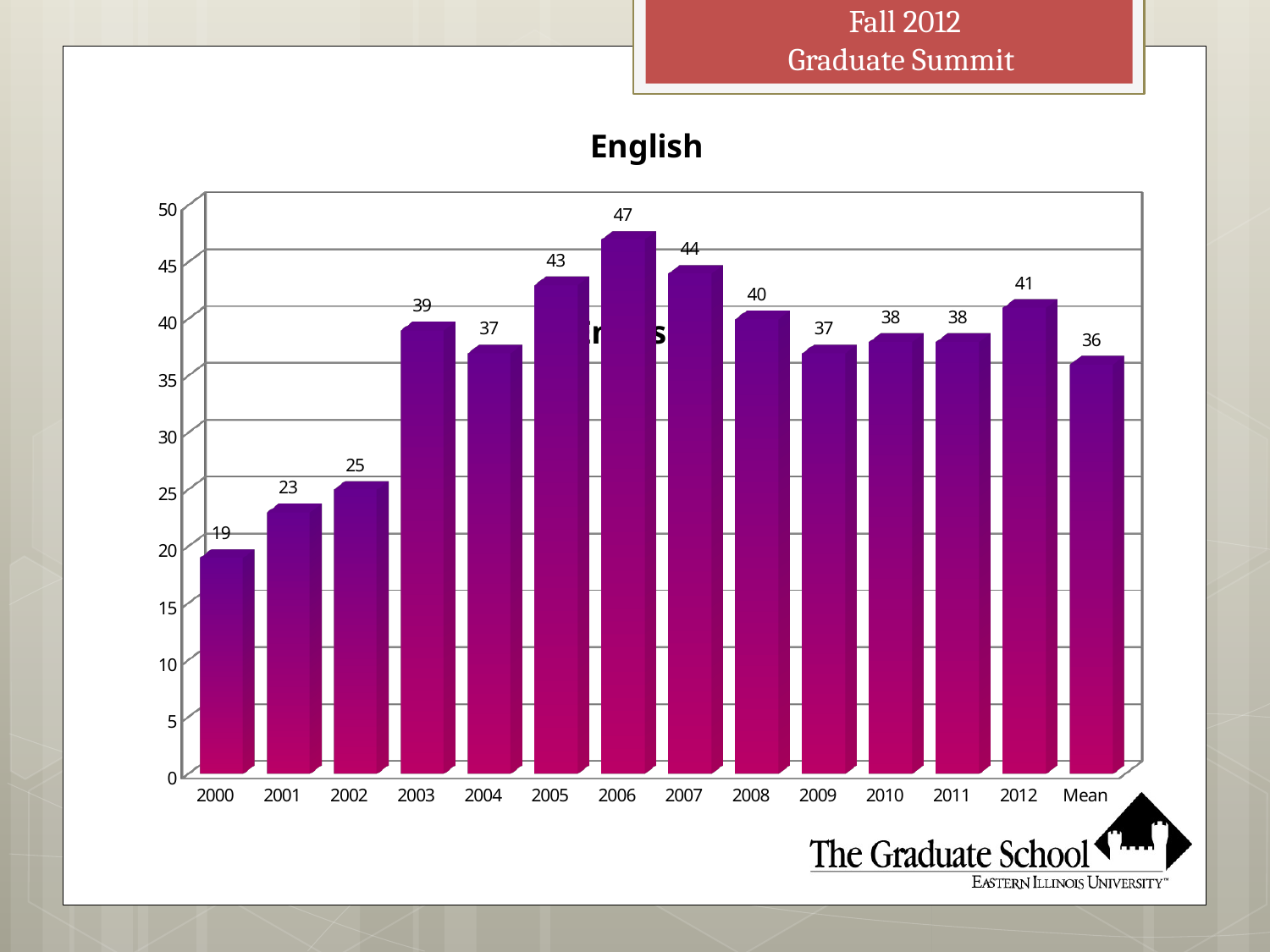
What is the title of the chart? English What is the value for 2006? 47 Do the values rise or fall from 2000 to 2006? rise What is the value for 2000? 19 Which year has the lowest value? 2000 Is the value for 2012 greater or less than 40? greater Which is larger, the value for 2003 or the value for 2004? 2003 Which year has the highest value? 2006 What is the difference between the values for 2006 and 2000? 28 What kind of chart is shown? bar chart What is the value shown for Mean? 36 How many bars are plotted in the chart? 14